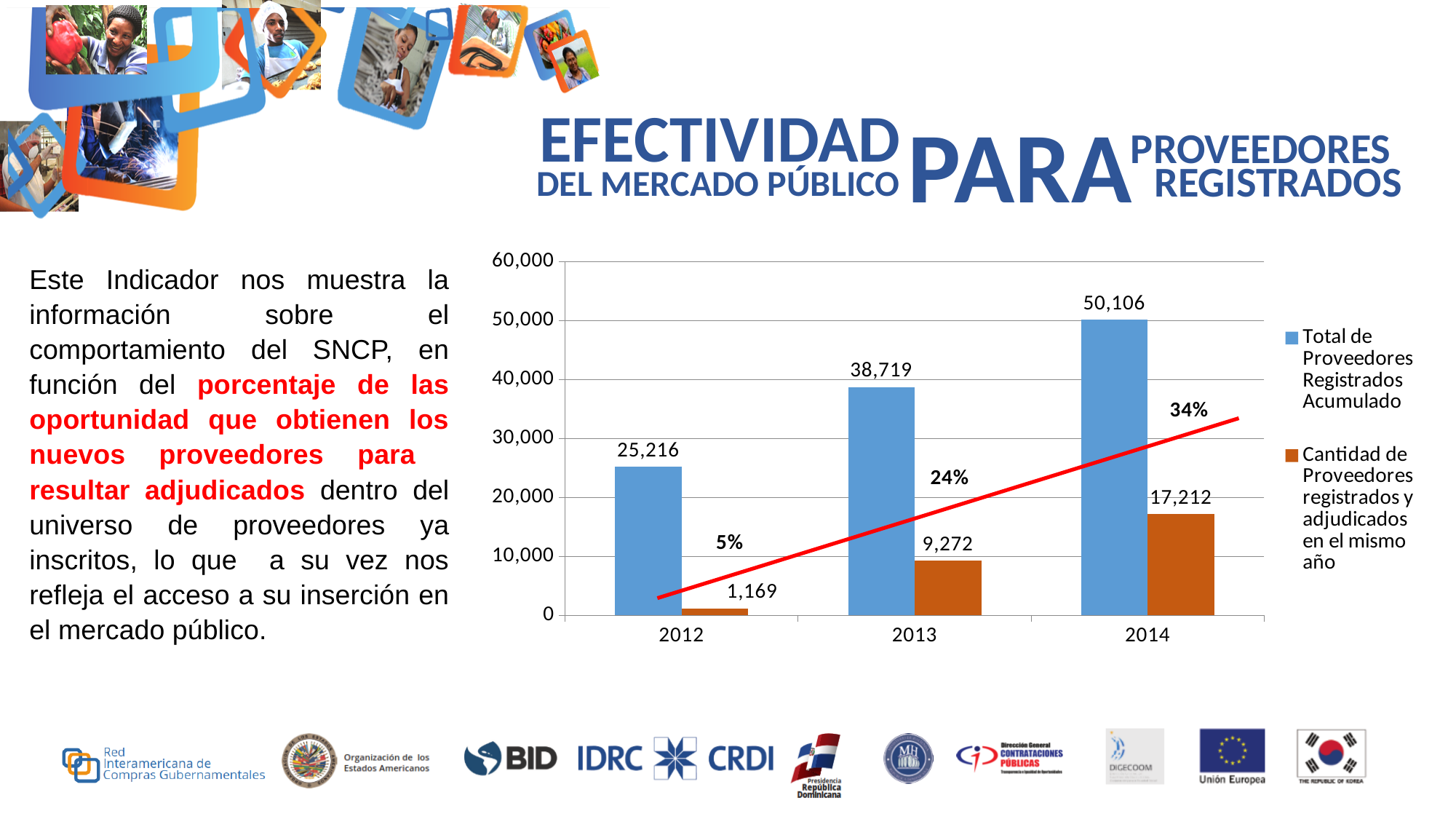
How many series does the legend list? 2 What is the value of Cantidad de Proveedores registrados y adjudicados en el mismo año for 2013? 9,272 Which is larger: Total de Proveedores Registrados Acumulado in 2012 or Cantidad de Proveedores registrados y adjudicados in 2014? Total de Proveedores Registrados Acumulado in 2012 Which year has the lowest Cantidad de Proveedores registrados y adjudicados en el mismo año? 2012 Does the Cantidad de Proveedores registrados y adjudicados en el mismo año rise or fall from 2012 to 2014? Rise What is the difference between Total de Proveedores Registrados Acumulado in 2014 and 2013? 11,387 What is the value of Cantidad de Proveedores registrados y adjudicados en el mismo año for 2012? 1,169 What is the value of Total de Proveedores Registrados Acumulado for 2014? 50,106 What kind of chart is shown on the slide? Bar chart What percentage label is shown for 2013? 24% Which year has the highest Total de Proveedores Registrados Acumulado? 2014 How many years are shown on the x axis? 3